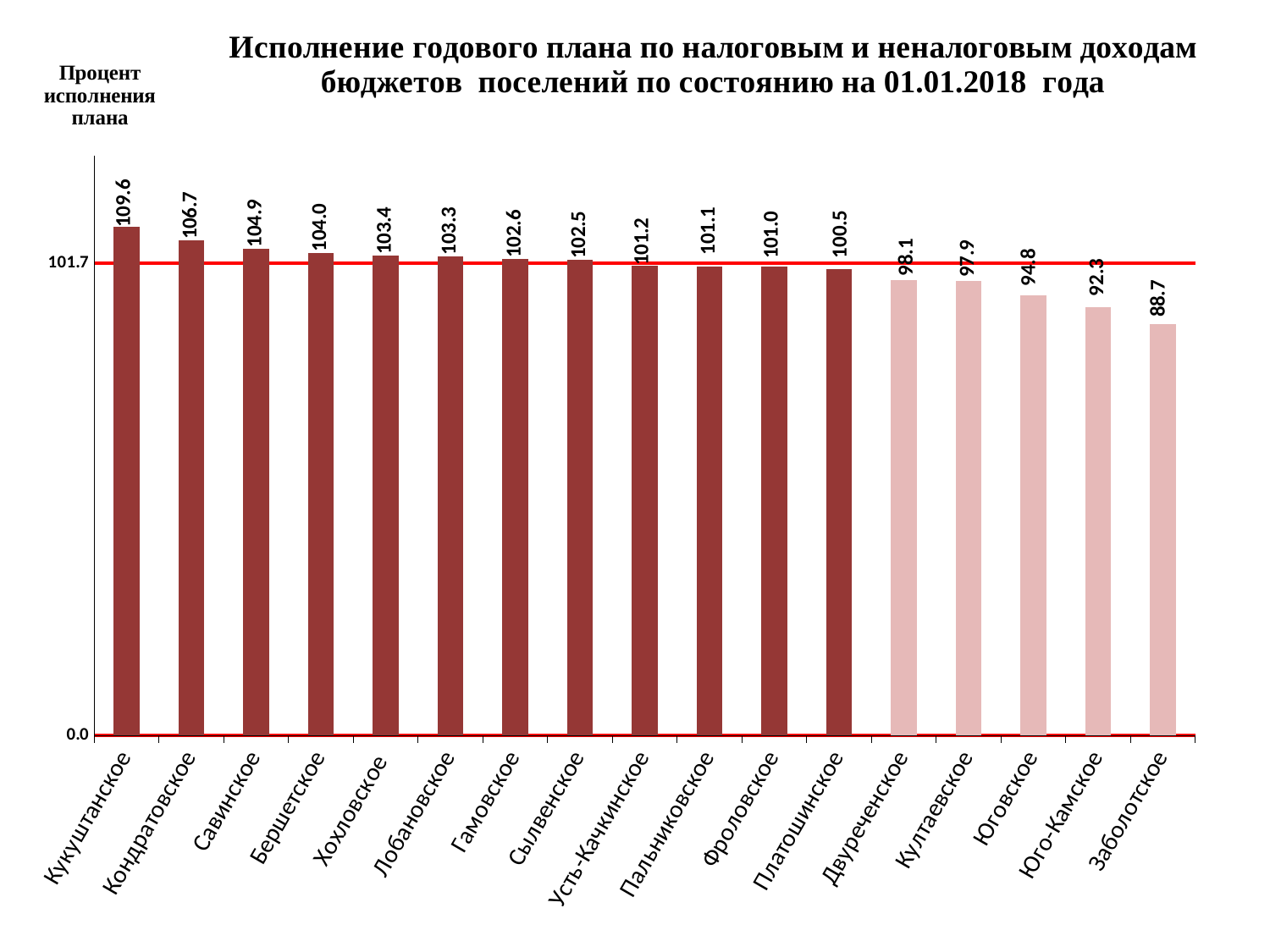
What kind of chart is shown on the slide? Bar chart What is the difference between the values for Кукуштанское and Заболотское? 20.9 What is the value for Хохловское? 103.4 What is the difference between the values for Кондратовское and Савинское? 1.8 What is the value for Заболотское? 88.7 What is the value for Кукуштанское? 109.6 Which is larger, the value for Юговское or the value for Юго-Камское? Юговское Which category has the highest value? Кукуштанское What is the value for Двуреченское? 98.1 What value is marked by the horizontal red line on the chart? 101.7 Which category has the lowest value? Заболотское How many categories are shown on the x axis? 17